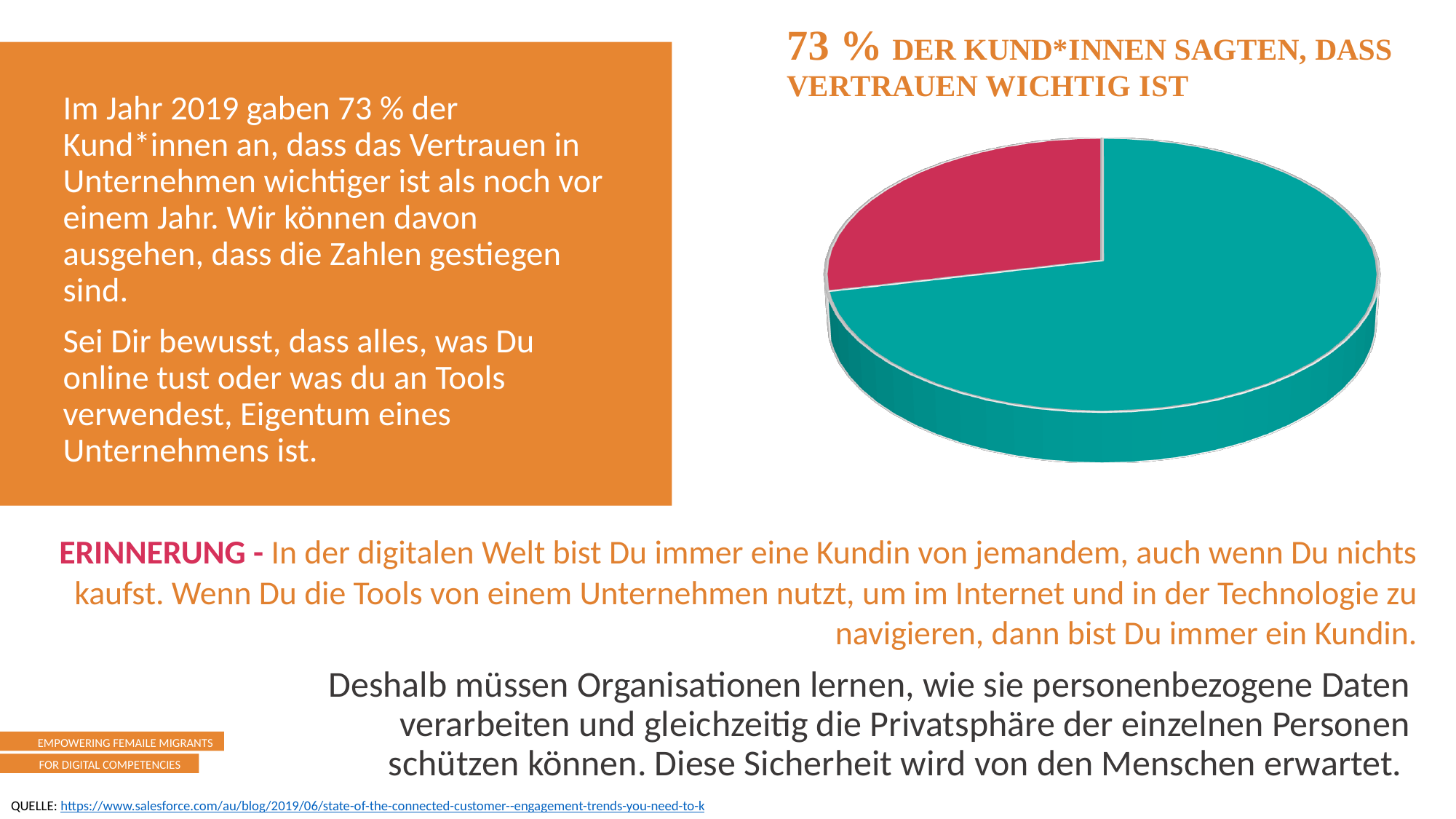
Which colour is the largest slice of the pie chart? teal What is the title of the pie chart? 73 % DER KUND*INNEN SAGTEN, DASS VERTRAUEN WICHTIG IST Does the pie chart show a legend? No According to the chart title, what percentage of customers said that trust is important? 73 % What kind of chart is shown on the slide? pie chart Which colour is the smallest slice of the pie chart? red How many slices does the pie chart have? 2 Which slice of the pie chart is larger, the teal one or the red one? the teal one